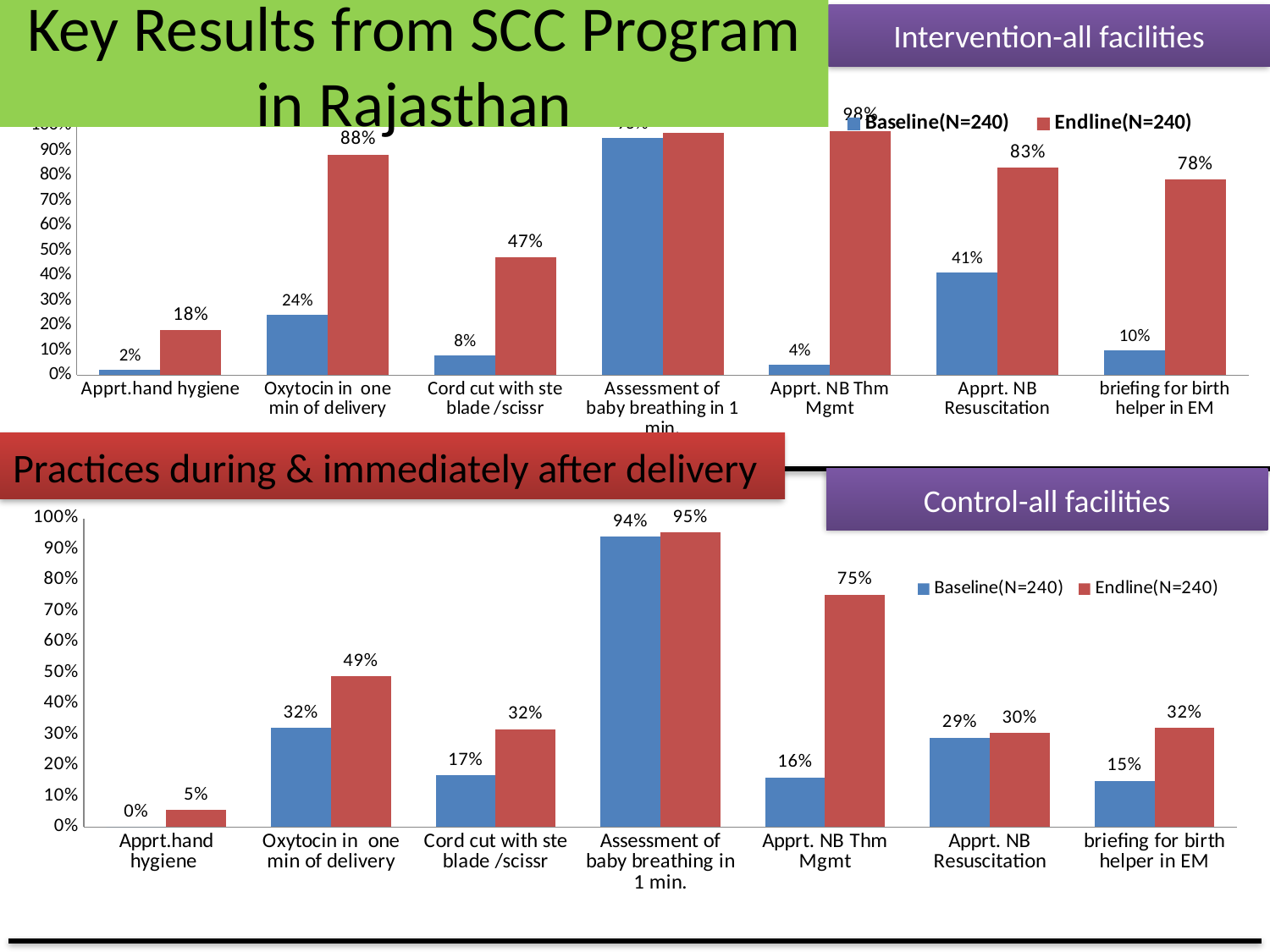
How many series does the legend of the Control-all facilities chart list? 2 In the Intervention-all facilities chart, what is the Endline value for Oxytocin in one min of delivery? 88% In the Intervention-all facilities chart, what is the difference between the Endline and Baseline values for Cord cut with ste blade /scissr? 39% In the Intervention-all facilities chart, which category has the lowest Baseline value? Apprt.hand hygiene In the Control-all facilities chart, what is the difference between the Endline and Baseline values for Oxytocin in one min of delivery? 17% In the Control-all facilities chart, what is the Baseline value for Apprt.hand hygiene? 0% In the Control-all facilities chart, which is larger: the Baseline value for Cord cut with ste blade /scissr or the Baseline value for Apprt. NB Thm Mgmt? Cord cut with ste blade /scissr In the Intervention-all facilities chart, is the Endline value for briefing for birth helper in EM greater or less than 70%? greater In the Control-all facilities chart, which category has the highest Endline value? Assessment of baby breathing in 1 min. How many categories are shown on the x axis of the Control-all facilities chart? 7 In the Control-all facilities chart, what is the Endline value for Apprt. NB Thm Mgmt? 75% In the Intervention-all facilities chart, what is the Baseline value for Apprt. NB Resuscitation? 41%